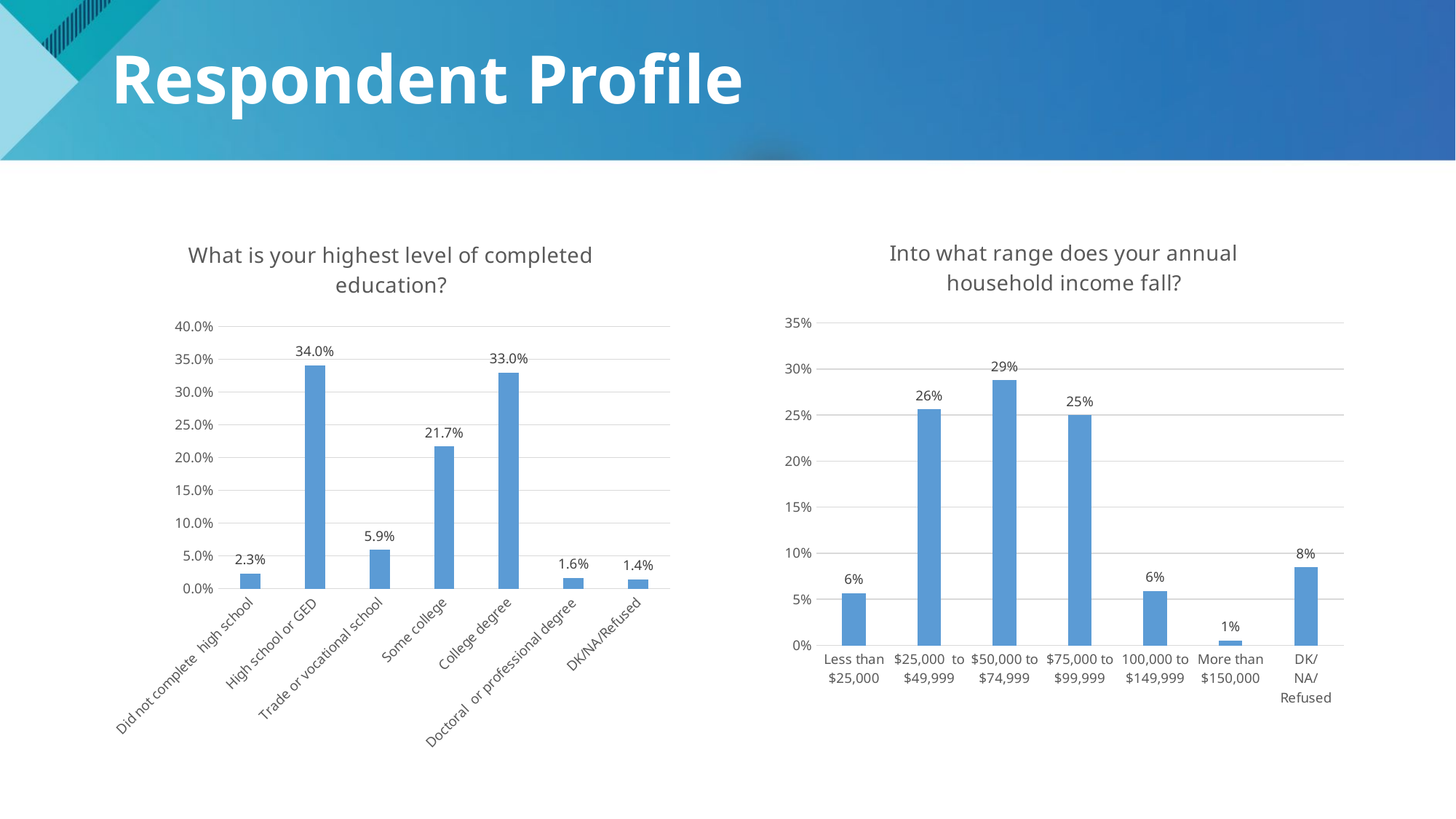
In the household income chart, which income range has the lowest value? More than $150,000 In the education chart, what percentage of respondents have a high school or GED education? 34.0% In the household income chart, what percentage of respondents answered DK/NA/Refused? 8% In the education chart, what is the difference between the High school or GED value and the College degree value? 1.0% In the education chart, what percentage of respondents completed some college? 21.7% In the education chart, how many categories are shown on the x axis? 7 In the household income chart, what percentage of respondents fall in the $50,000 to $74,999 range? 29% In the household income chart, what is the difference between the $50,000 to $74,999 value and the $75,000 to $99,999 value? 4% In the household income chart, which is larger: the value for $25,000 to $49,999 or the value for $75,000 to $99,999? $25,000 to $49,999 What type of chart is the household income chart? Bar chart In the education chart, which category has the lowest value? DK/NA/Refused In the education chart, which category has the highest value? High school or GED